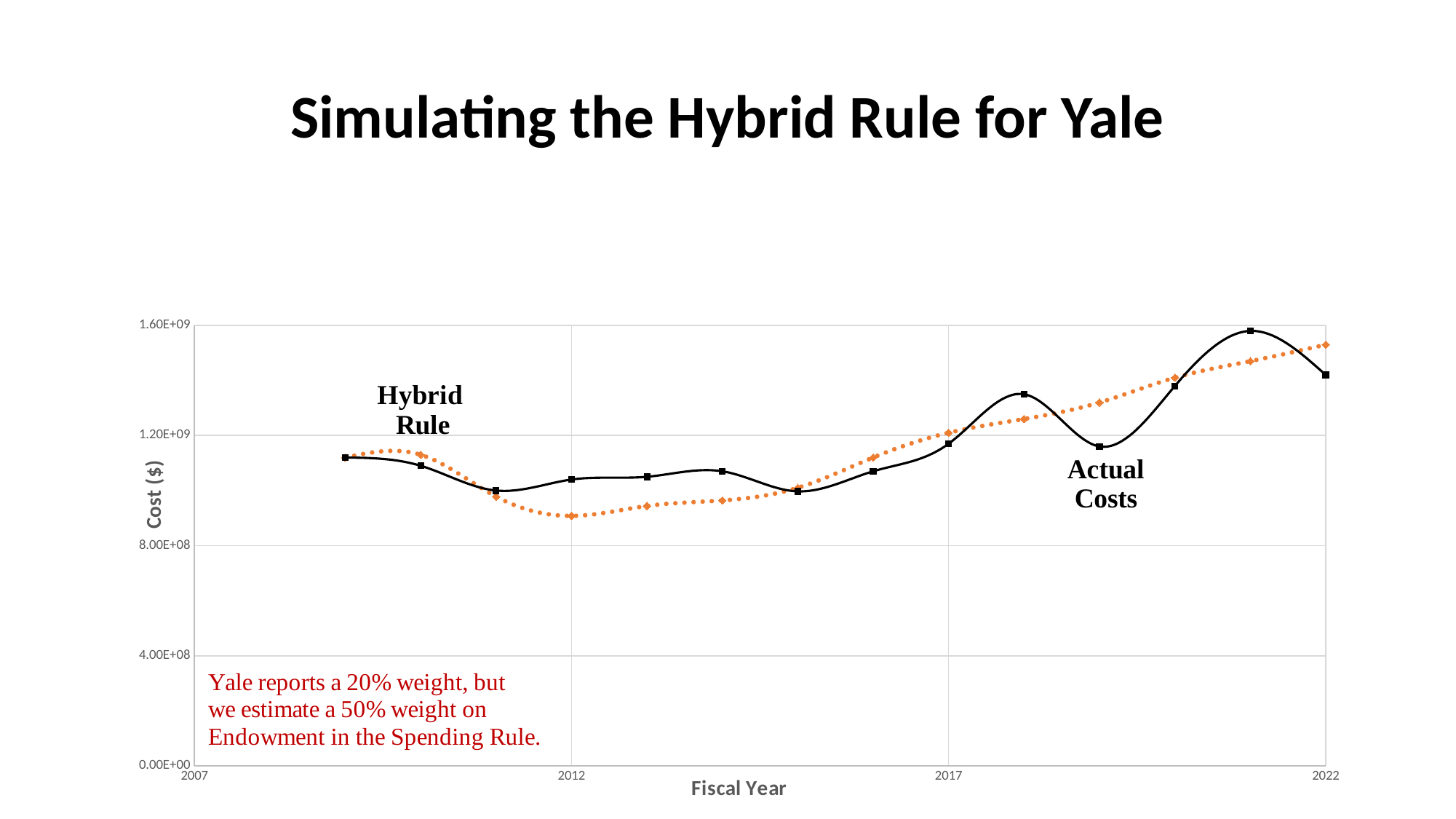
In 2019, which series has the higher value, Hybrid Rule or Actual Costs? Hybrid Rule What is the title of the chart on the slide? Simulating the Hybrid Rule for Yale In which fiscal year does the Hybrid Rule series reach its lowest value? 2012 Is the Hybrid Rule value for 2012 greater or less than 1.00E+09? less Is the Actual Costs value for 2021 greater or less than 1.40E+09? greater How many series are plotted on the chart? 2 Is the Hybrid Rule value for 2022 greater or less than 1.40E+09? greater What is the label of the x axis of the chart? Fiscal Year In which fiscal year does the Actual Costs series reach its highest value? 2021 How many data points does the Actual Costs series have? 14 What kind of chart is shown on the slide? line chart Does the Hybrid Rule series rise or fall from 2012 to 2022? rise